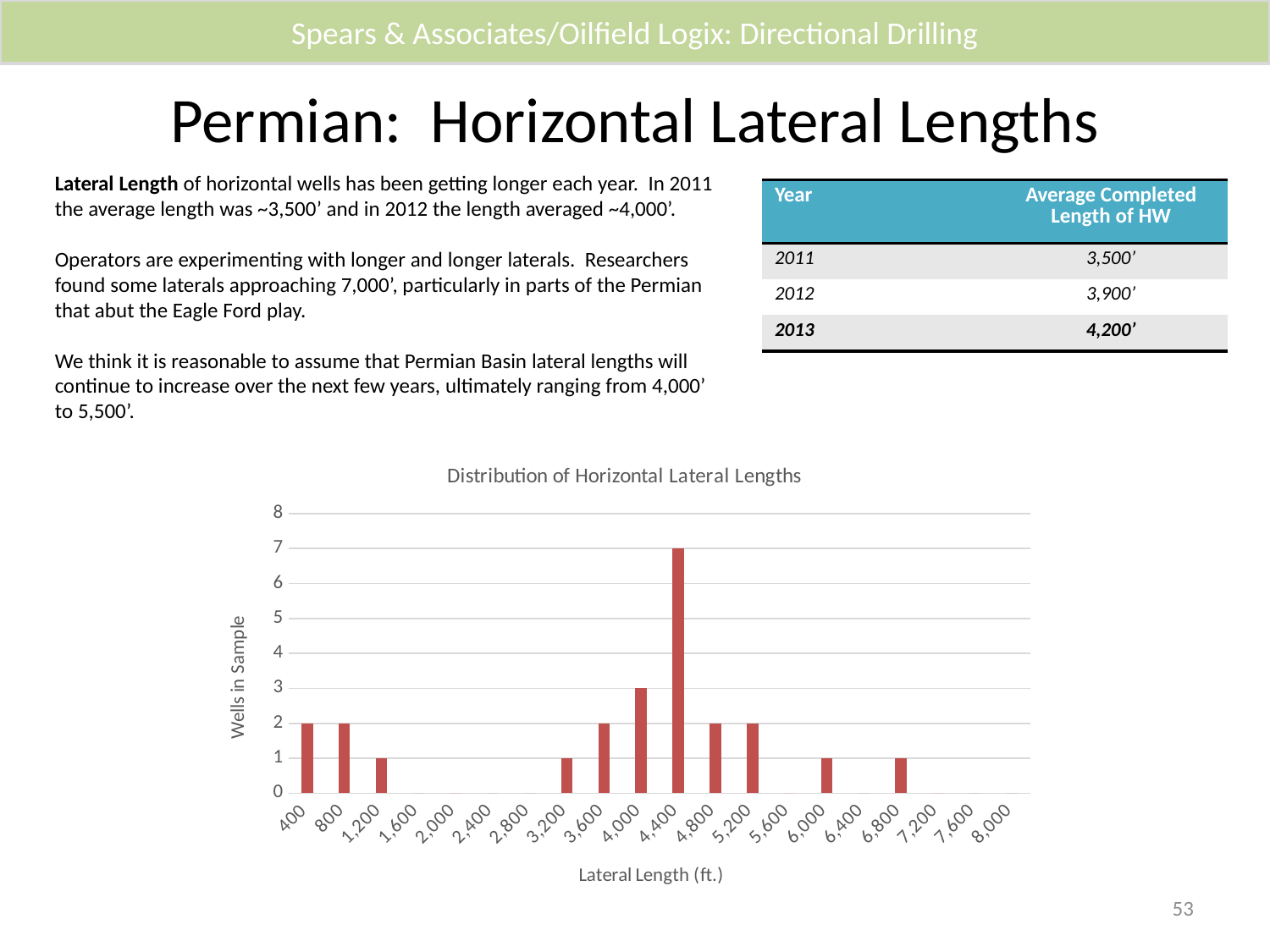
In the "Distribution of Horizontal Lateral Lengths" chart, is the number of wells at a lateral length of 4,400 greater or less than 5? greater In the "Distribution of Horizontal Lateral Lengths" chart, which has more wells in the sample: a lateral length of 3,600 or 4,000? 4,000 What is the x-axis title of the "Distribution of Horizontal Lateral Lengths" chart? Lateral Length (ft.) In the "Distribution of Horizontal Lateral Lengths" chart, how many wells in the sample have a lateral length of 4,400? 7 In the "Distribution of Horizontal Lateral Lengths" chart, how many wells in the sample have a lateral length of 4,000? 3 What kind of chart is shown under the title "Distribution of Horizontal Lateral Lengths"? bar chart In the "Distribution of Horizontal Lateral Lengths" chart, how many wells in the sample have a lateral length of 6,800? 1 In the "Distribution of Horizontal Lateral Lengths" chart, how many lateral length categories have at least one well in the sample (i.e., how many bars are shown)? 11 In the "Distribution of Horizontal Lateral Lengths" chart, which lateral length has the highest number of wells in the sample? 4,400 What is the y-axis title of the "Distribution of Horizontal Lateral Lengths" chart? Wells in Sample In the "Distribution of Horizontal Lateral Lengths" chart, how many wells in the sample have a lateral length of 1,200? 1 In the "Distribution of Horizontal Lateral Lengths" chart, what is the difference between the number of wells at 4,400 and the number at 4,000? 4